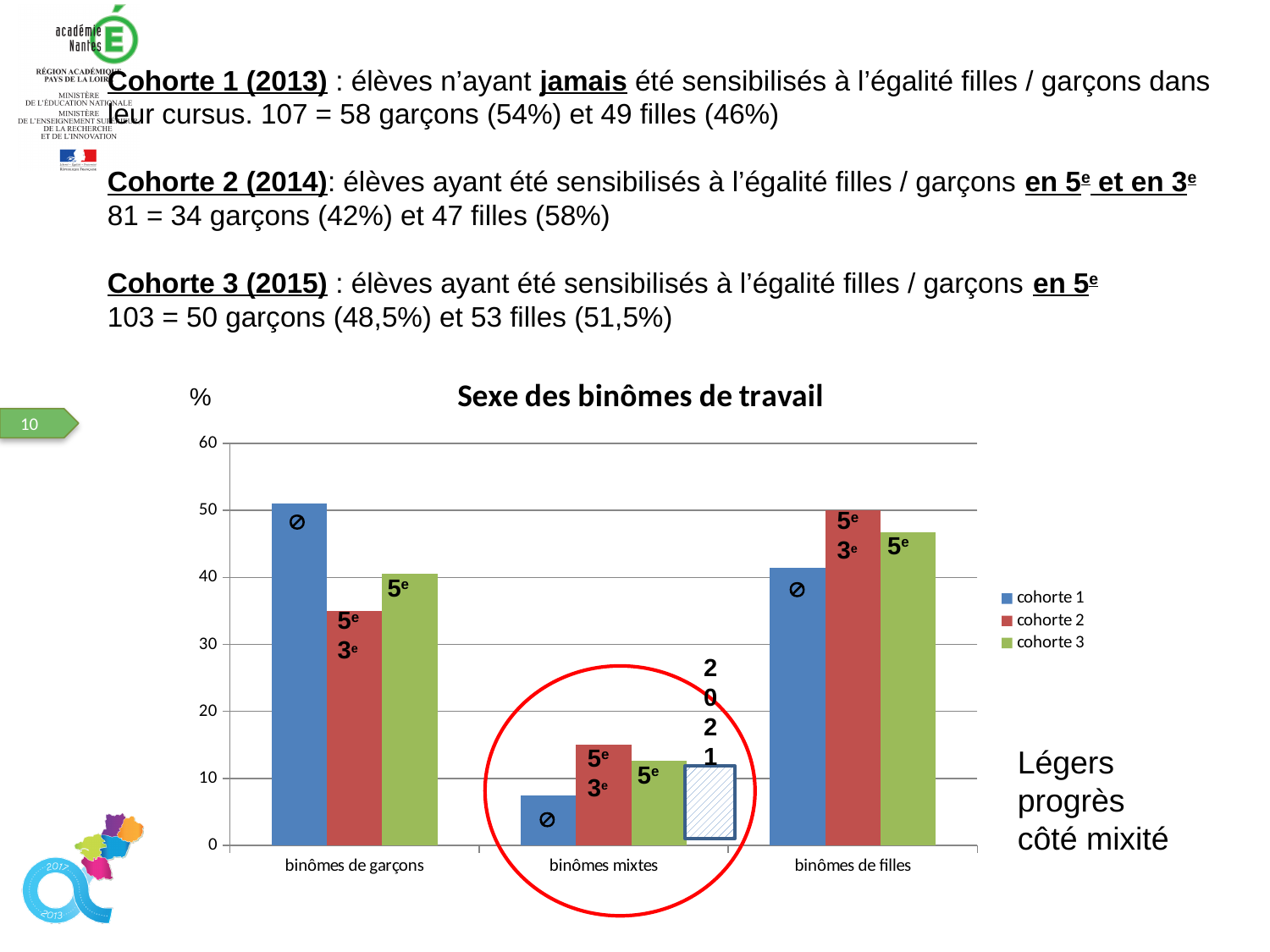
For binômes de garçons, which is larger: cohorte 2 or cohorte 3? cohorte 3 Which cohort has the highest value for binômes de garçons? cohorte 1 Which cohort has the lowest value for binômes mixtes? cohorte 1 Is the value for cohorte 1 in binômes mixtes greater or less than 10? less How many categories are shown on the x axis of the chart? 3 What kind of chart is shown on the slide? bar chart What is the title of the chart? Sexe des binômes de travail How many series does the chart legend list? 3 Is the value for cohorte 2 in binômes mixtes greater or less than 10? greater Which cohort has the highest value for binômes de filles? cohorte 2 Is the value for cohorte 3 in binômes de filles greater or less than 40? greater